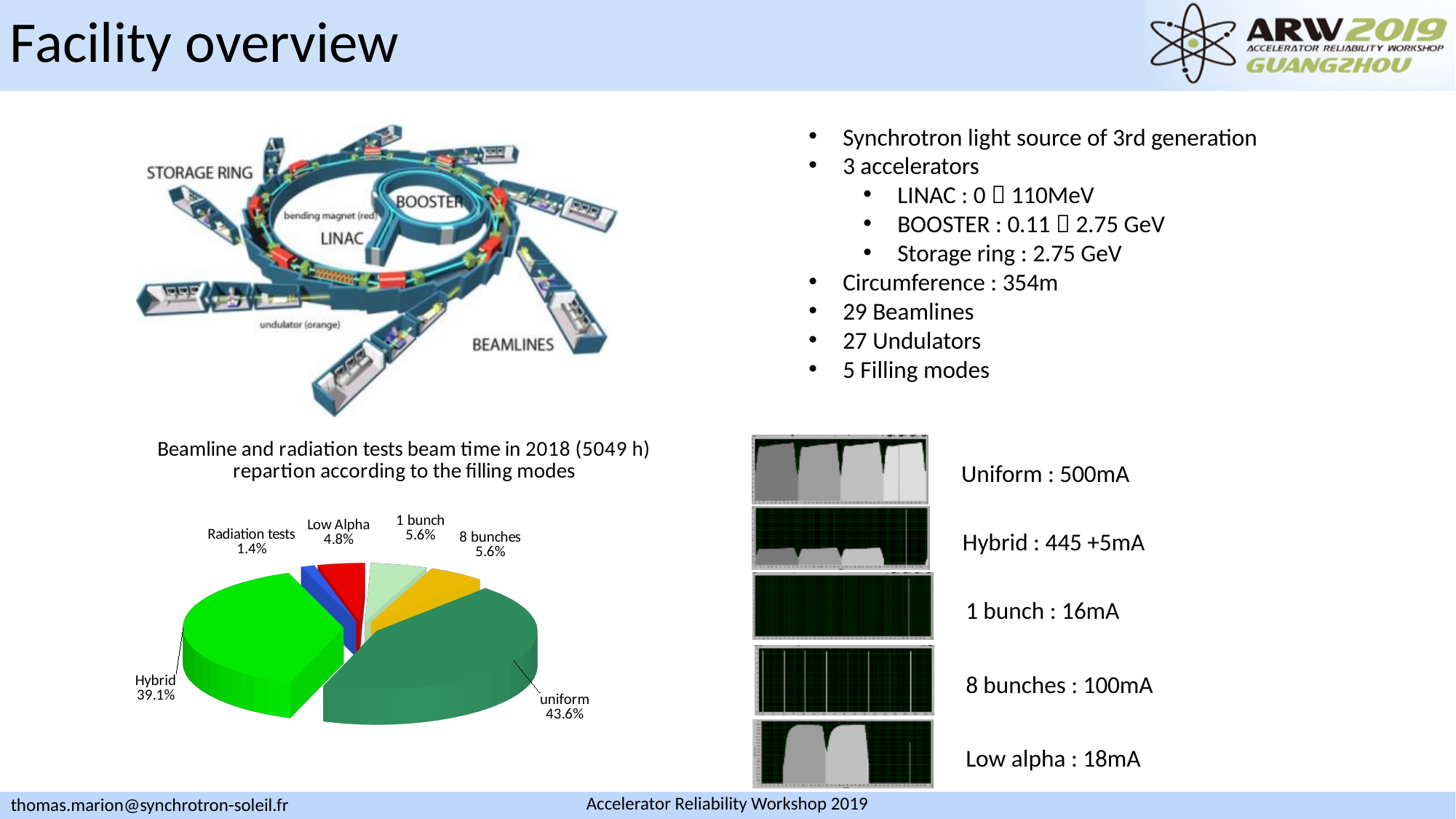
What share of the pie chart does the Hybrid filling mode have? 39.1% Which slice of the pie chart is the largest? uniform What is the value shown for Low Alpha in the pie chart? 4.8% What share of the pie chart does the uniform filling mode have? 43.6% Which is larger in the pie chart, Low Alpha or 1 bunch? 1 bunch What kind of chart is shown on the slide? pie chart How many slices does the pie chart have? 6 Which slice of the pie chart is the smallest? Radiation tests What is the title of the pie chart? Beamline and radiation tests beam time in 2018 (5049 h) repartion according to the filling modes What is the value shown for 8 bunches in the pie chart? 5.6% What is the value shown for Radiation tests in the pie chart? 1.4% What is the difference between the uniform and Hybrid shares in the pie chart? 4.5%